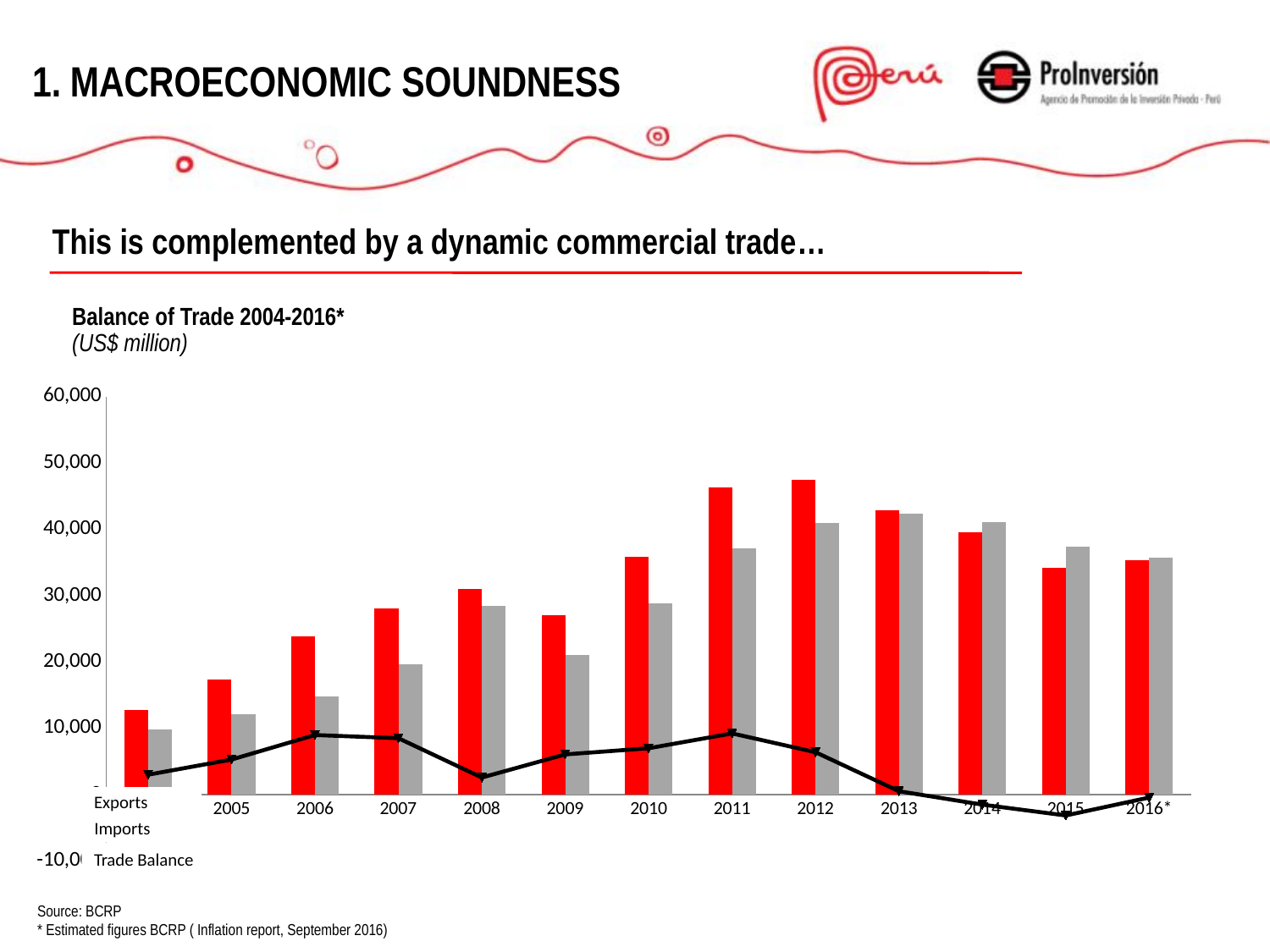
Is the Trade Balance value for 2015 greater or less than 0? less Is the value for Exports in 2012 greater or less than 40,000? greater What kind of chart is used for the Exports and Imports series in the Balance of Trade chart? Bar chart Do Exports rise or fall from 2005 to 2008? Rise In 2015, which is larger, Exports or Imports? Imports What is the title of the chart on the slide? Balance of Trade 2004-2016* Which series in the Balance of Trade chart is drawn as a black line? Trade Balance Does the Trade Balance rise or fall from 2011 to 2015? Fall How many series does the legend of the Balance of Trade chart list? 3 In 2011, which is larger, Exports or Imports? Exports Is the value for Exports in 2006 greater or less than 20,000? greater